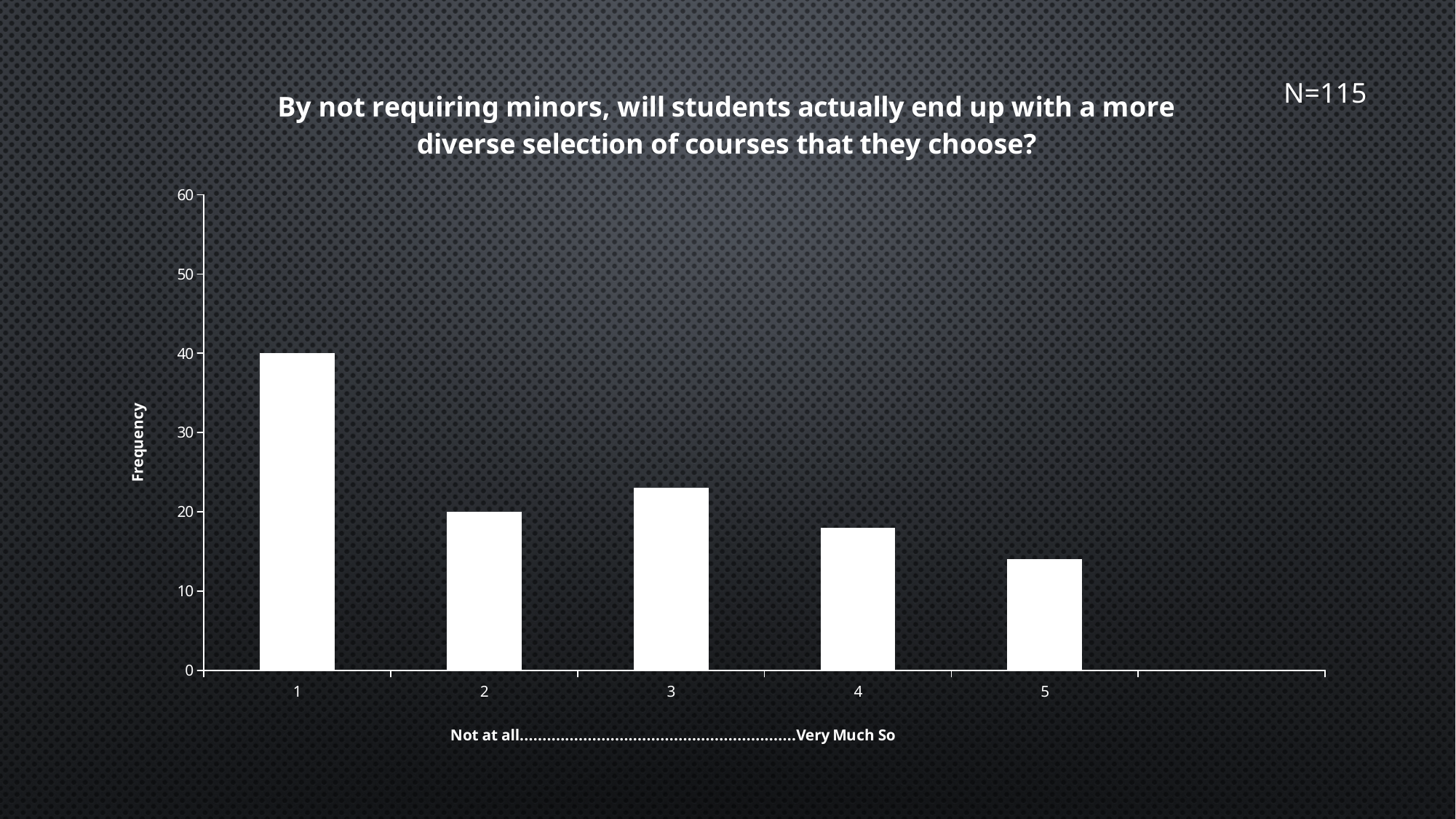
Is the frequency for response 3 greater or less than 20? greater What kind of chart is shown on the slide? bar chart What is the label on the y axis? Frequency What is the difference in frequency between response 1 and response 2? 20 Which response category has the highest frequency? 1 Is the frequency for response 4 greater or less than 20? less Is the frequency for response 5 greater or less than 10? greater What is the frequency for response 2? 20 What is the frequency for response 1? 40 How many response categories are shown on the x axis? 5 Which response category has the lowest frequency? 5 Which has a higher frequency, response 3 or response 4? 3